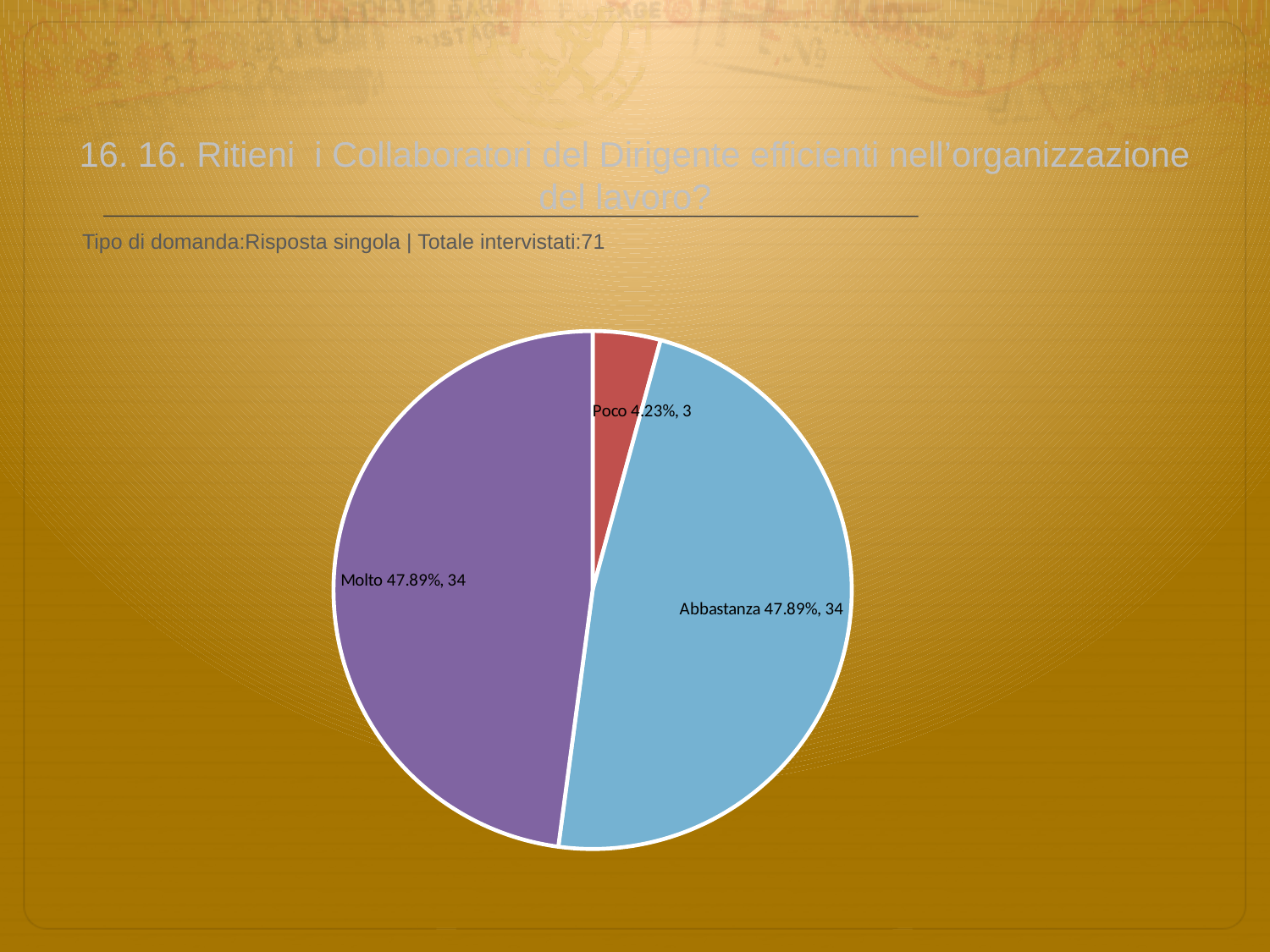
What is the count for the Molto slice? 34 What percentage share does the Poco slice have? 4.23% Which slice is the smallest? Poco How many slices does the pie chart have? 3 What colour is the Molto slice? purple What percentage share does the Abbastanza slice have? 47.89% What is the count for the Poco slice? 3 Which is larger, the Abbastanza slice or the Poco slice? Abbastanza What colour is the Poco slice? red What is the difference in count between Molto and Poco? 31 What is the total count across all slices of the pie chart? 71 What kind of chart is shown on the slide? pie chart